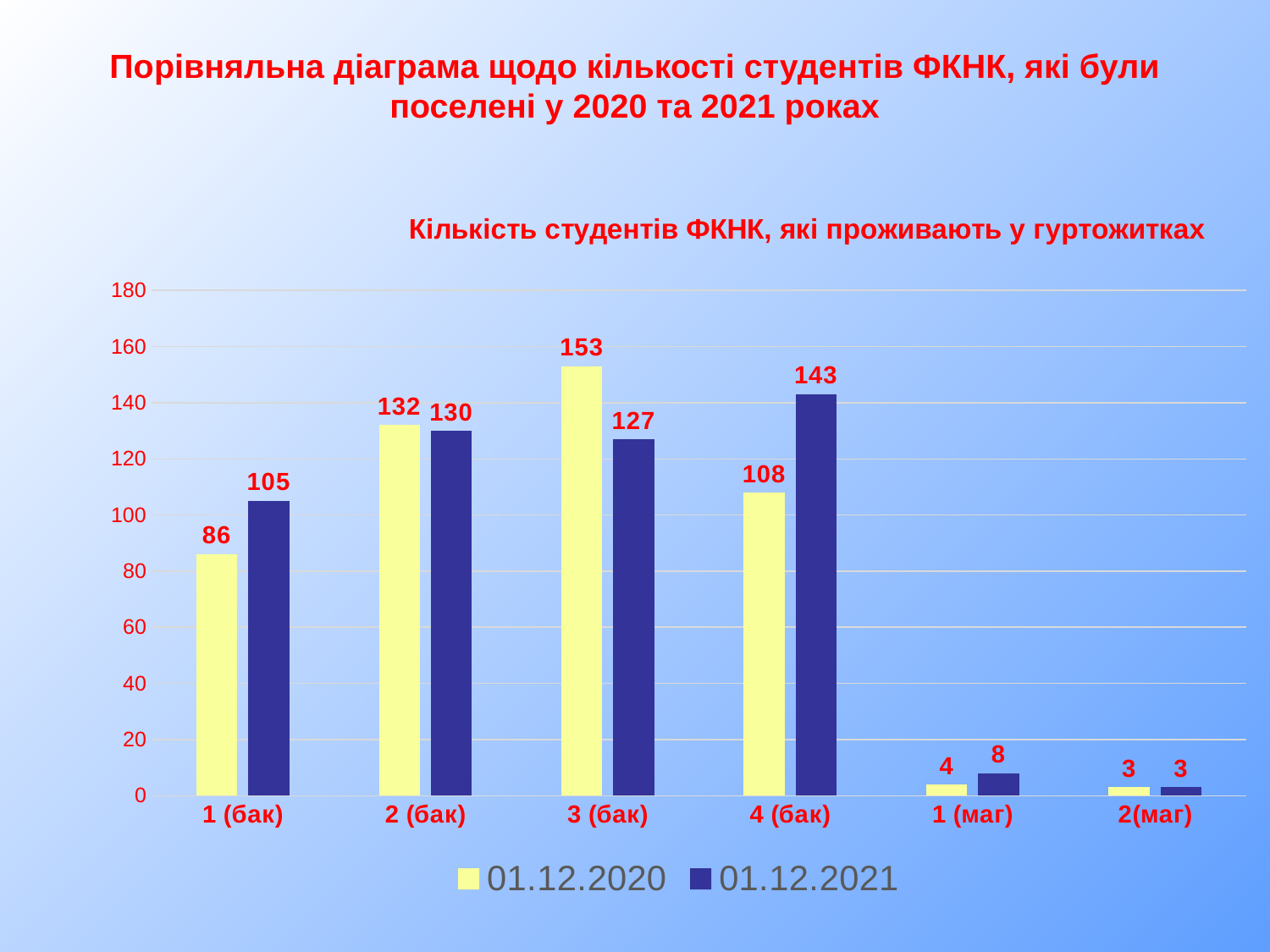
What is the difference between the 01.12.2021 and 01.12.2020 values for 4 (бак)? 35 How many categories are shown on the x axis? 6 What is the value for 1 (бак) in the 01.12.2020 series? 86 Which category has the lowest value in the 01.12.2021 series? 2(маг) Which series is shown in yellow? 01.12.2020 What is the value for 4 (бак) in the 01.12.2021 series? 143 Which category has the highest value in the 01.12.2020 series? 3 (бак) What kind of chart is shown on the slide? bar chart What is the value for 1 (маг) in the 01.12.2021 series? 8 Which is larger for 3 (бак): the 01.12.2020 value or the 01.12.2021 value? 01.12.2020 What is the title of the chart? Кількість студентів ФКНК, які проживають у гуртожитках How many series does the legend list? 2